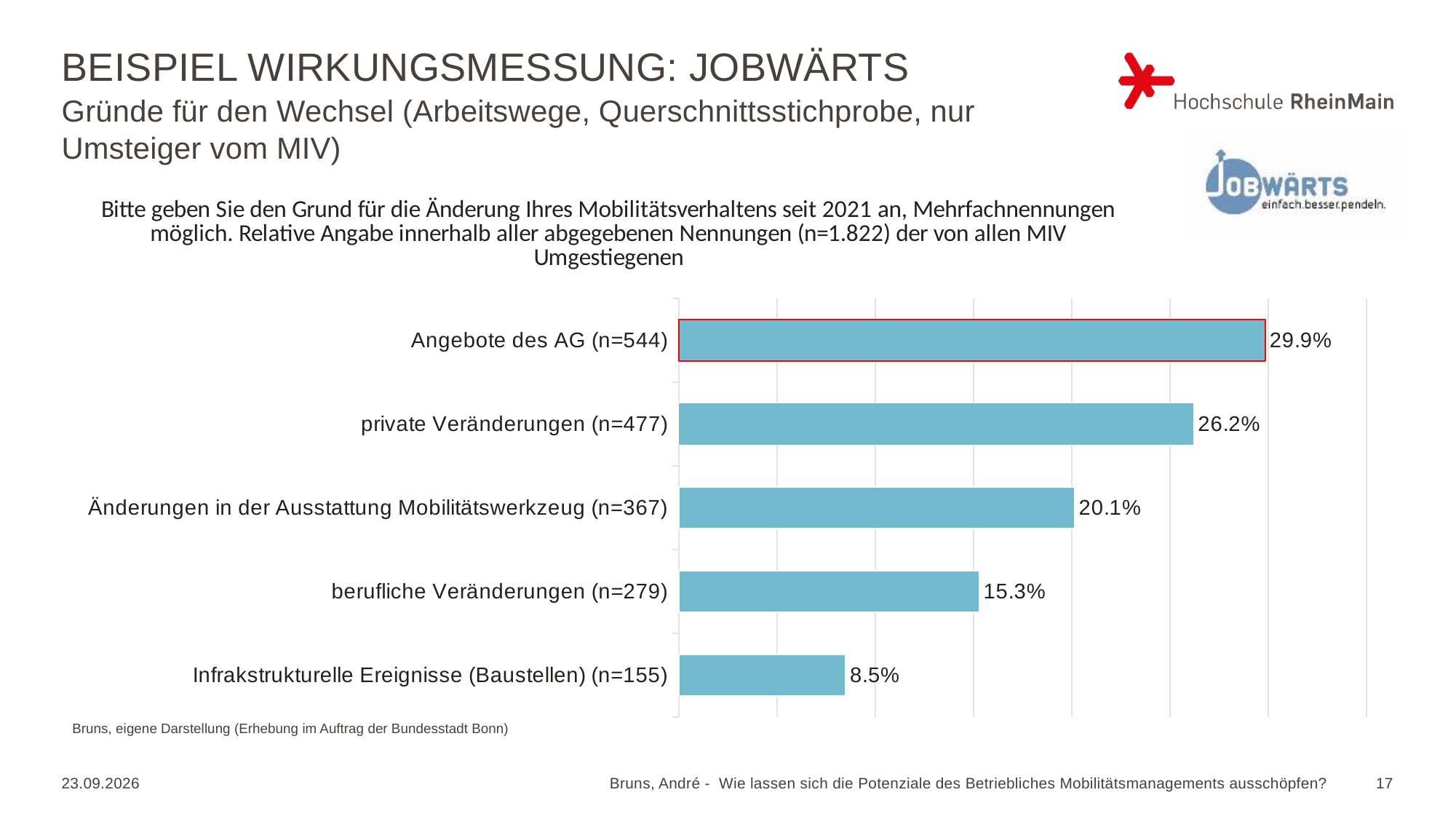
What is the difference between the values for "Angebote des AG (n=544)" and "private Veränderungen (n=477)"? 3.7% What is the value for "Infrakstrukturelle Ereignisse (Baustellen) (n=155)"? 8.5% How many categories are shown in the chart? 5 What kind of chart is shown on the slide? Bar chart What is the value for "Änderungen in der Ausstattung Mobilitätswerkzeug (n=367)"? 20.1% Which category has the lowest value? Infrakstrukturelle Ereignisse (Baustellen) (n=155) Which is larger: the value for "berufliche Veränderungen (n=279)" or "Infrakstrukturelle Ereignisse (Baustellen) (n=155)"? berufliche Veränderungen (n=279) What is the value for "Angebote des AG (n=544)"? 29.9% Which bar is outlined with a red border? Angebote des AG (n=544) Which category has the highest value? Angebote des AG (n=544) What is the value for "private Veränderungen (n=477)"? 26.2% What is the value for "berufliche Veränderungen (n=279)"? 15.3%